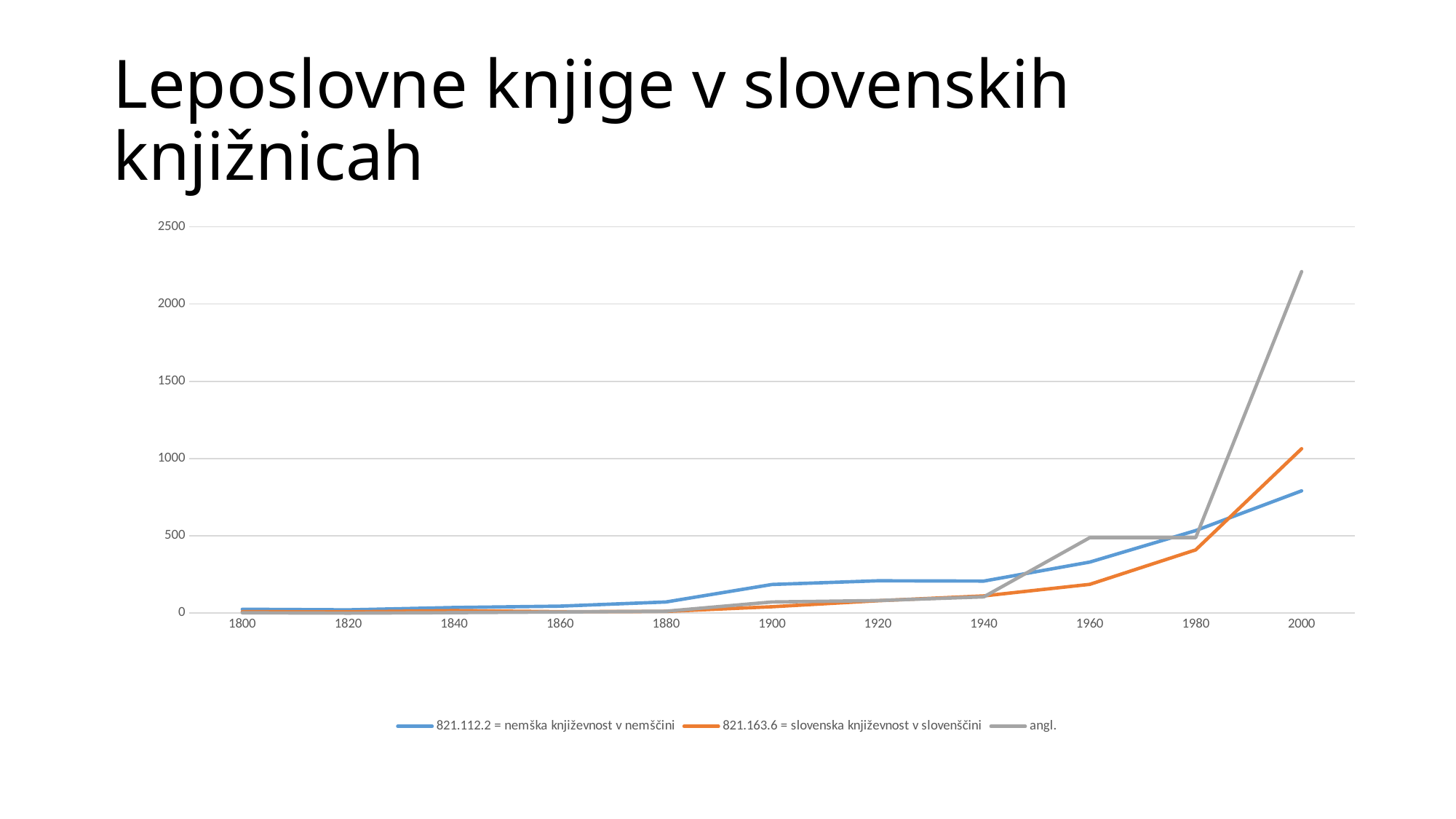
How many series does the legend list? 3 Is the value for angl. in 2000 greater or less than 2000? greater Is the value for 821.112.2 = nemška književnost v nemščini in 1960 greater or less than 500? less Which series has the lowest value in 2000? 821.112.2 = nemška književnost v nemščini In 1900, which is larger: the value for 821.112.2 = nemška književnost v nemščini or for 821.163.6 = slovenska književnost v slovenščini? 821.112.2 = nemška književnost v nemščini How many years are marked on the x axis? 11 Is the value for 821.112.2 = nemška književnost v nemščini in 2000 greater or less than 1000? less Do the values for 821.163.6 = slovenska književnost v slovenščini rise or fall from 1800 to 2000? rise Which series has the highest value in 2000? angl. What is the title of the slide containing the chart? Leposlovne knjige v slovenskih knjižnicah What kind of chart is shown on the slide? line chart